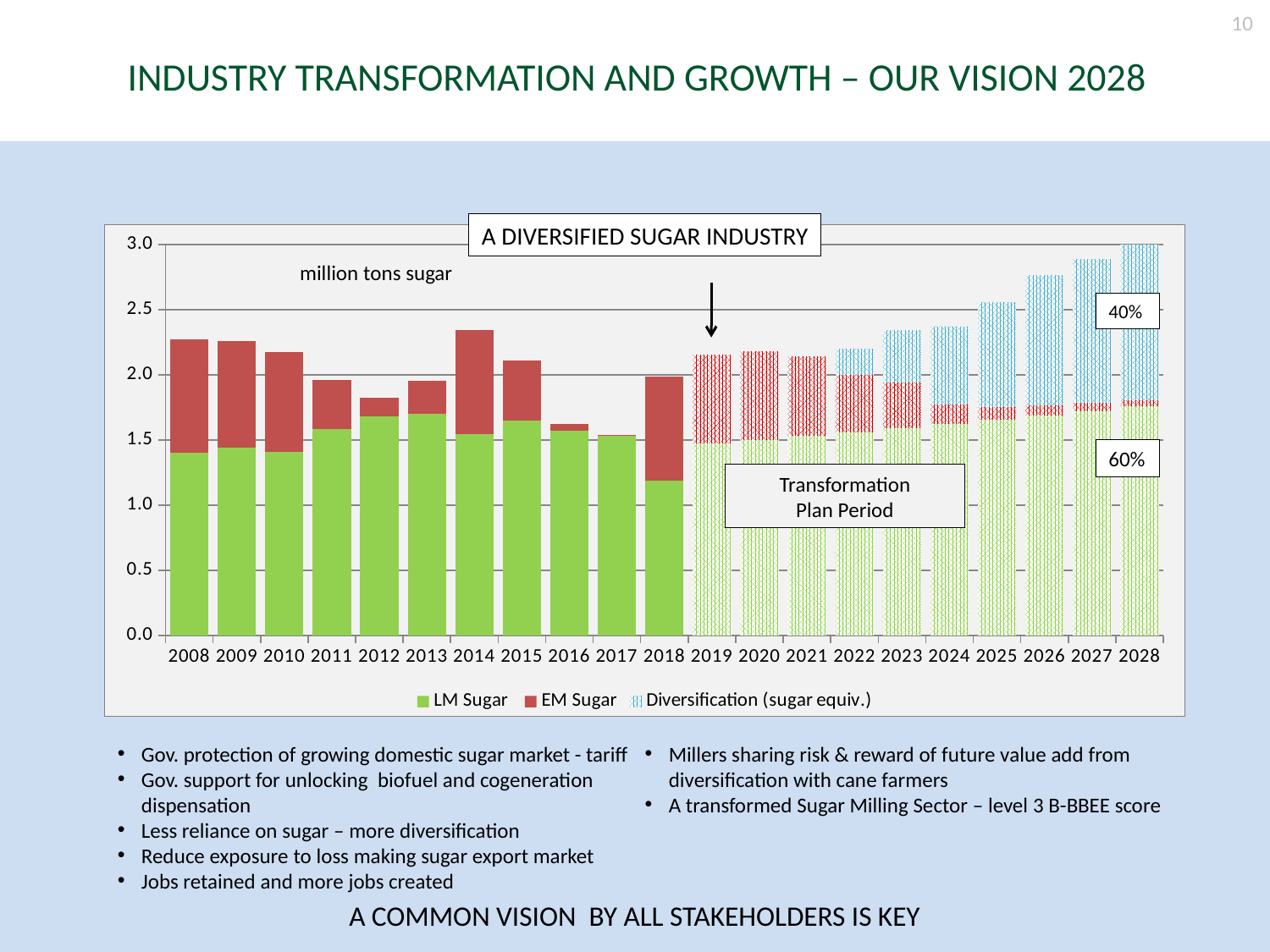
Do the total bars rise or fall from 2019 to 2028? rise Which year has the highest total bar in the chart? 2028 How many series does the chart legend list? 3 Is the total bar for 2014 greater or less than 2.0? greater How many years are shown along the x axis of the chart? 21 Is the LM Sugar value for 2018 greater or less than 1.5? less Which year has the larger total bar, 2008 or 2012? 2008 Which year has the lowest total bar in the chart? 2017 Which year has the lowest LM Sugar value in the chart? 2018 Is the total bar for 2012 greater or less than 2.0? less What kind of chart is shown on the slide? bar chart What is the title shown on the chart? A DIVERSIFIED SUGAR INDUSTRY